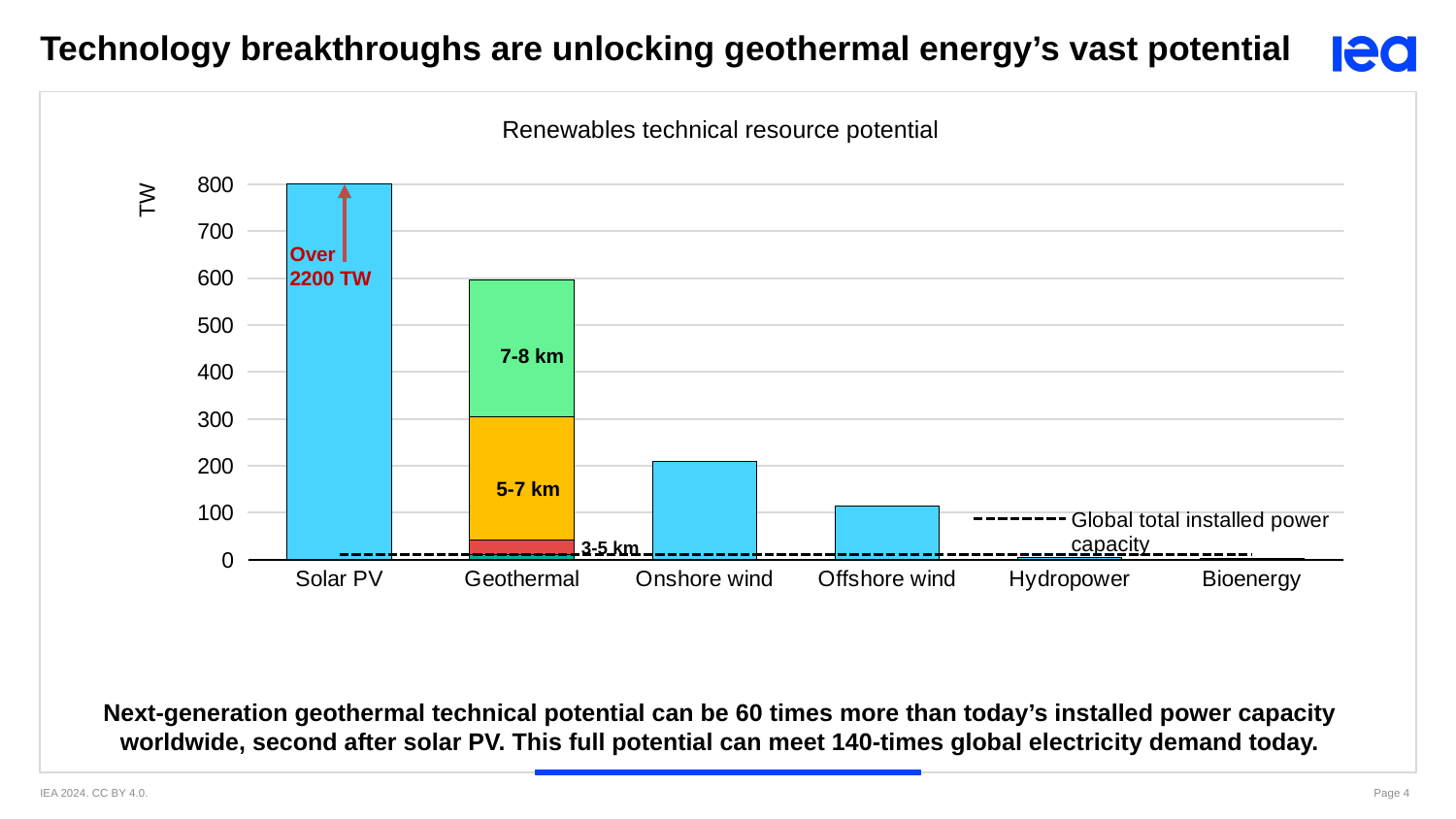
What value is annotated on the Solar PV bar? Over 2200 TW What type of chart is shown on the slide? bar chart How many categories are shown on the x axis of the chart? 6 Is the value for Hydropower greater or less than 100? less What does the dashed horizontal line on the chart represent? Global total installed power capacity What is the title of the chart? Renewables technical resource potential Which is larger, the value for Onshore wind or the value for Offshore wind? Onshore wind Is the value for Geothermal greater or less than 500? greater Is the value for Offshore wind greater or less than 200? less Which category has the highest technical resource potential? Solar PV Which is larger, the value for Geothermal or the value for Onshore wind? Geothermal